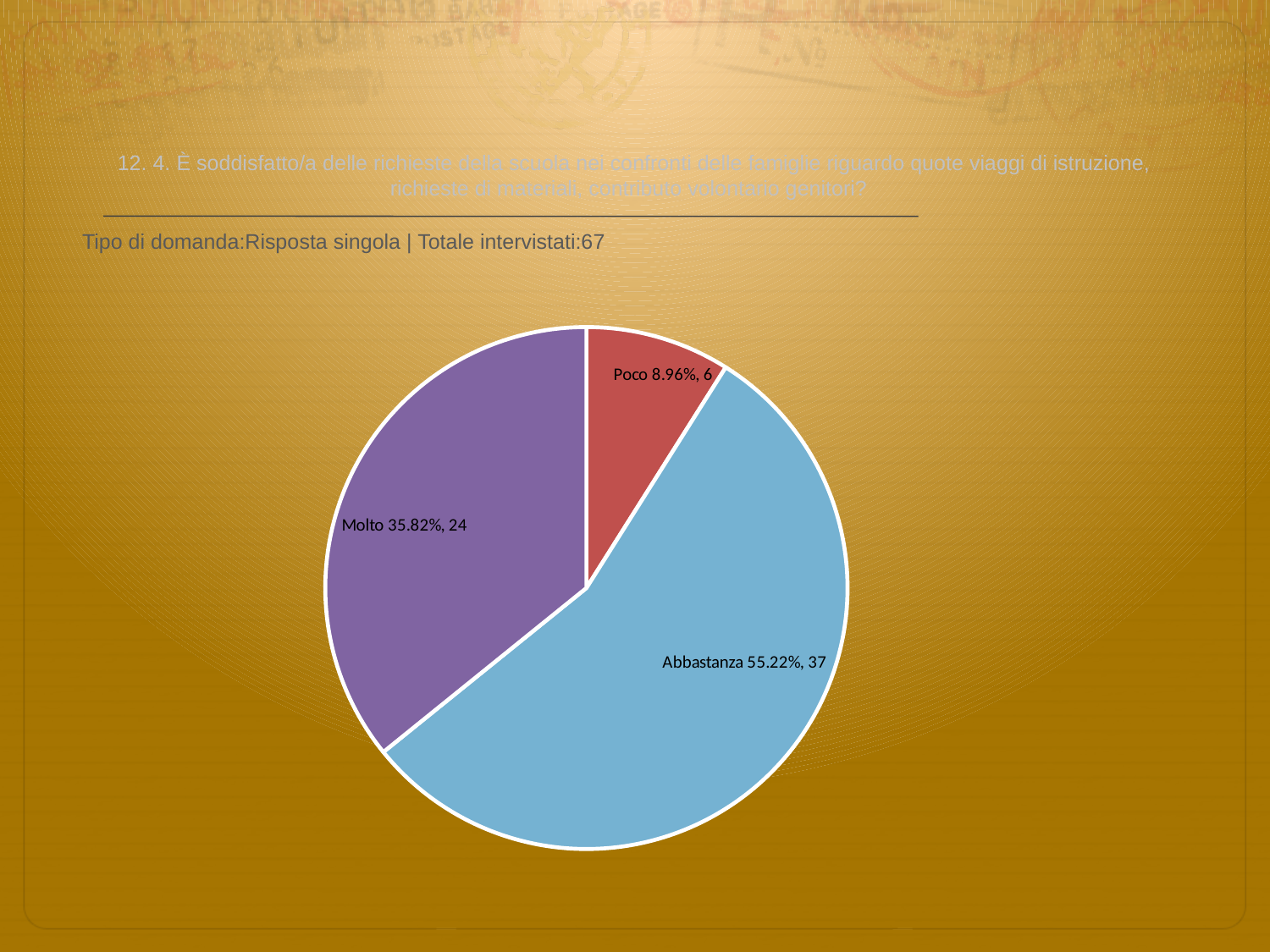
Which response has the smallest slice of the pie? Poco What percentage share does the Poco slice have? 8.96% How many respondents answered Poco? 6 What percentage share does the Abbastanza slice have? 55.22% What kind of chart is shown on the slide? pie chart What percentage share does the Molto slice have? 35.82% How many slices does the pie chart have? 3 Which slice is larger, Molto or Poco? Molto How many respondents answered Abbastanza? 37 How many more respondents answered Abbastanza than Molto? 13 How many respondents answered Molto? 24 Which response has the largest slice of the pie? Abbastanza